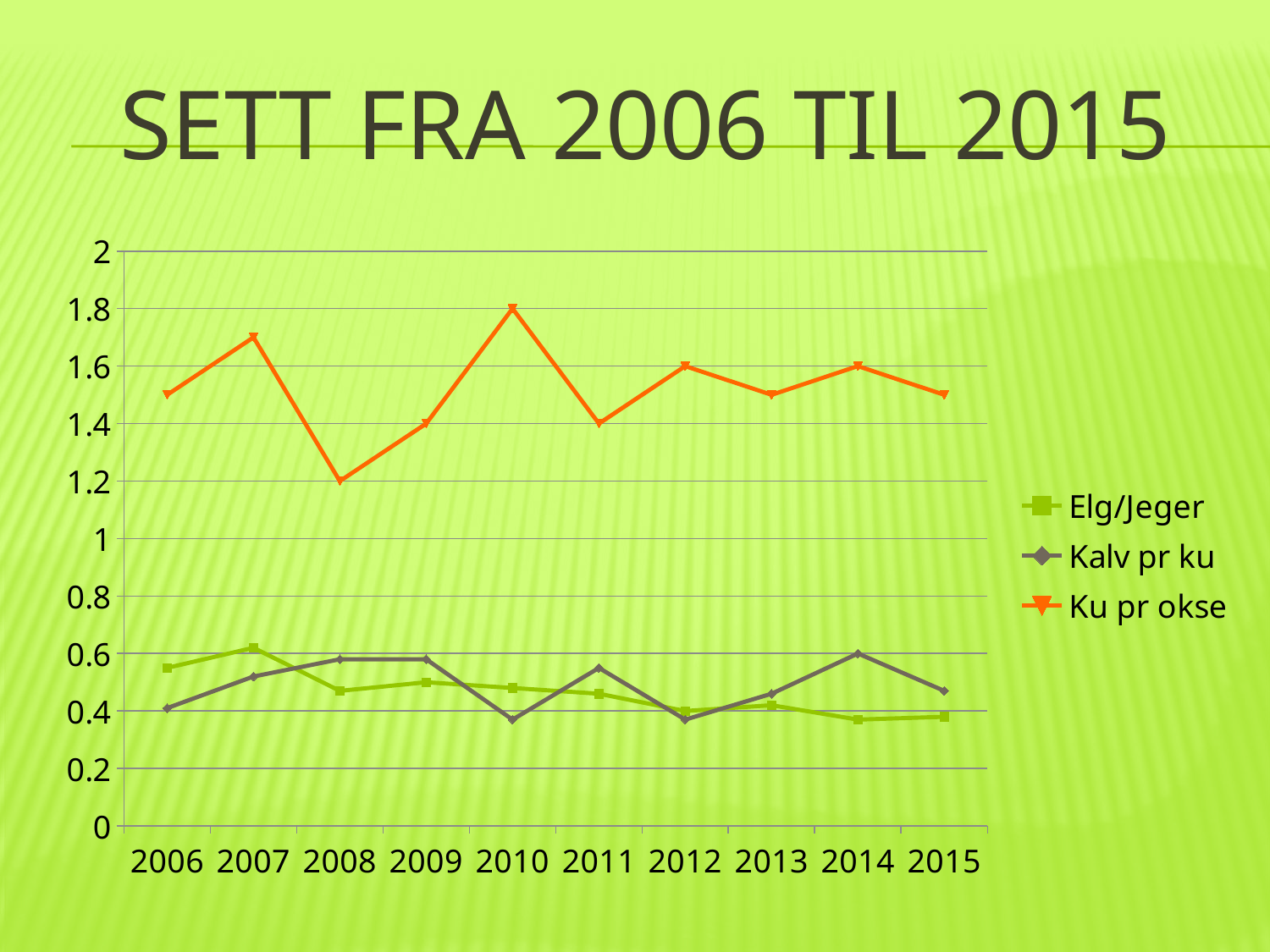
What kind of chart is shown on the slide? Line chart What is the value of Ku pr okse in 2008? 1.2 What is the difference between Ku pr okse in 2010 and in 2008? 0.6 Which series is plotted with the orange line? Ku pr okse What is the value of Kalv pr ku in 2014? 0.6 In which year is Ku pr okse lowest? 2008 What is the value of Ku pr okse in 2010? 1.8 Is the value for Ku pr okse in 2007 greater or less than 1.6? greater How many series does the legend list? 3 How many years are shown on the x axis? 10 In which year is Elg/Jeger highest? 2007 In which year is Ku pr okse highest? 2010